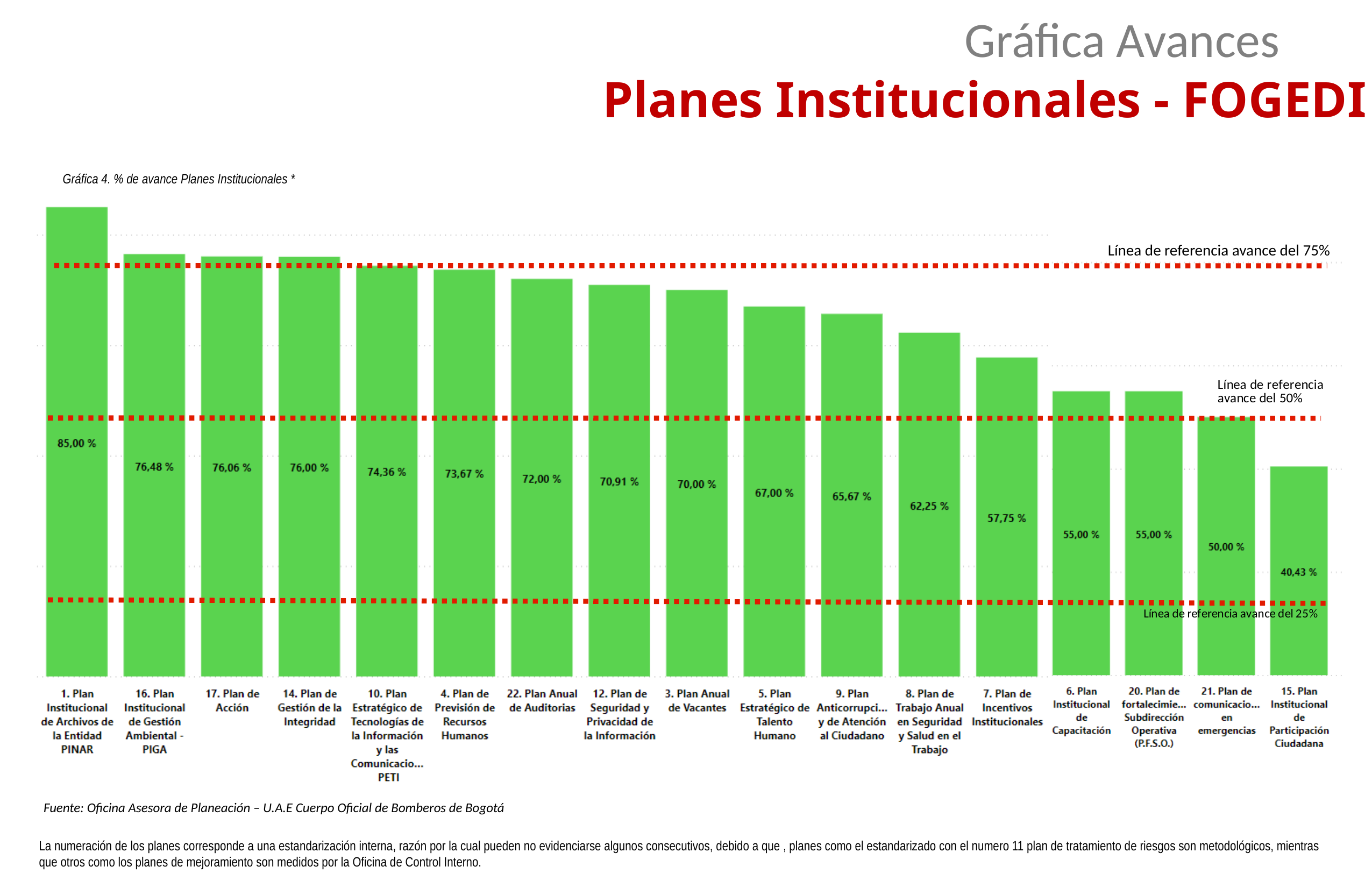
How many plans (bars) are shown in the chart? 17 Which has a larger value: "9. Plan Anticorrupción y de Atención al Ciudadano" or "8. Plan de Trabajo Anual en Seguridad y Salud en el Trabajo"? 9. Plan Anticorrupción y de Atención al Ciudadano What kind of chart is shown on the slide? Bar chart What is the value shown for "7. Plan de Incentivos Institucionales"? 57,75 % What is the difference between the value for "22. Plan Anual de Auditorias" and the value for "5. Plan Estratégico de Talento Humano"? 5,00 % Do the values rise or fall from left to right across the chart? Fall What is the value shown for "17. Plan de Acción"? 76,06 % What percentage does the top dotted reference line in the chart represent? 75% Which plan has the lowest percentage of progress in the chart? 15. Plan Institucional de Participación Ciudadana What is the value shown for "3. Plan Anual de Vacantes"? 70,00 % What is the difference between the value for "1. Plan Institucional de Archivos de la Entidad PINAR" and the value for "15. Plan Institucional de Participación Ciudadana"? 44,57 % Which plan has the highest percentage of progress in the chart? 1. Plan Institucional de Archivos de la Entidad PINAR